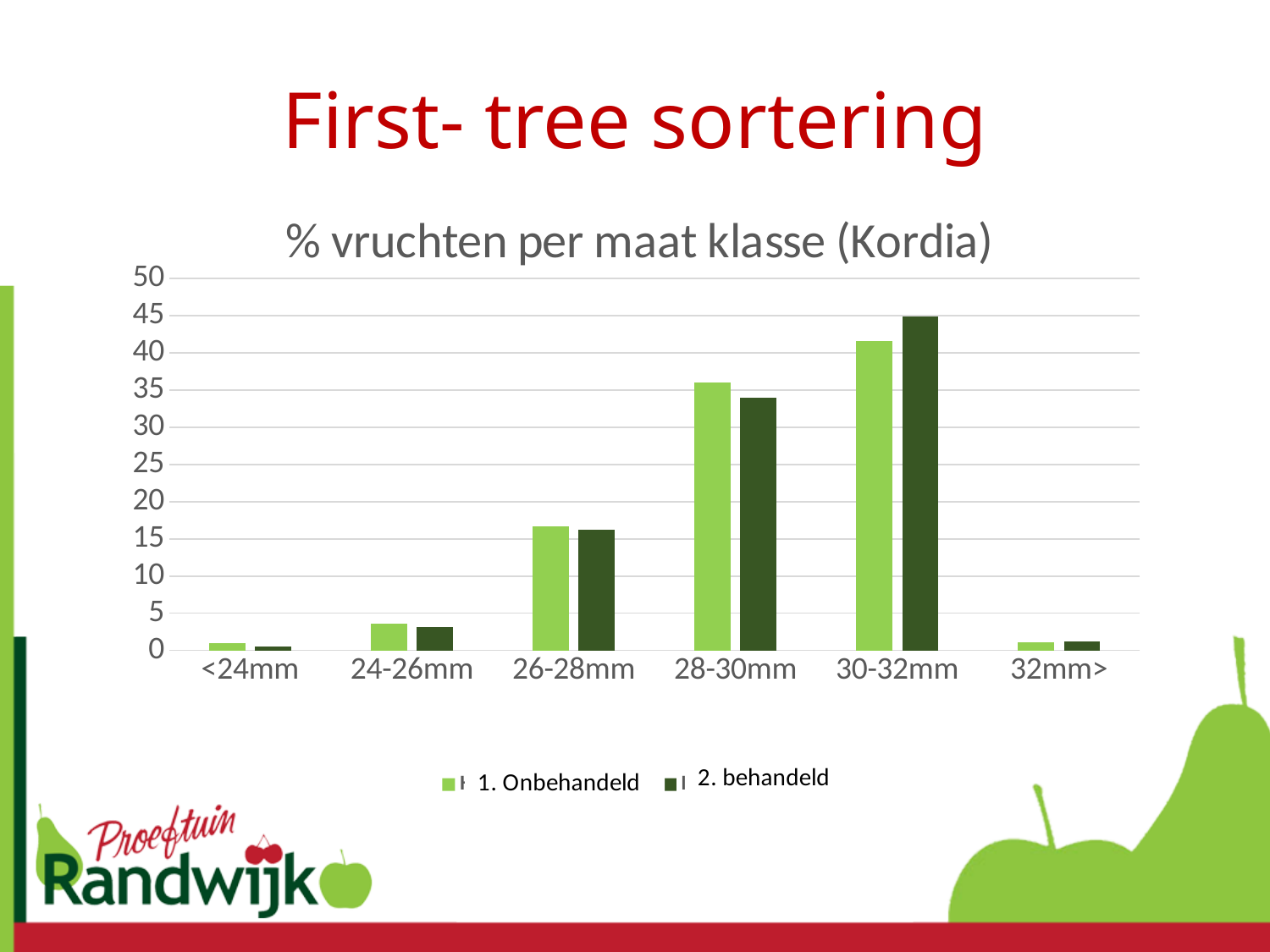
How many size classes are shown on the x axis? 6 Is the value for 2. behandeld in the 30-32mm class greater or less than 40? greater For the 30-32mm class, which series has the larger value, 1. Onbehandeld or 2. behandeld? 2. behandeld Which legend entry is shown in the darker green colour? 2. behandeld Which size class has the highest value for 1. Onbehandeld? 30-32mm Is the value for 1. Onbehandeld in the 26-28mm class greater or less than 20? less Which size class has the highest value for 2. behandeld? 30-32mm Is the value for 1. Onbehandeld in the 28-30mm class greater or less than 30? greater How many series does the legend list? 2 What is the title of the chart? % vruchten per maat klasse (Kordia) What kind of chart is shown on the slide? bar chart For the 28-30mm class, which series has the larger value, 1. Onbehandeld or 2. behandeld? 1. Onbehandeld